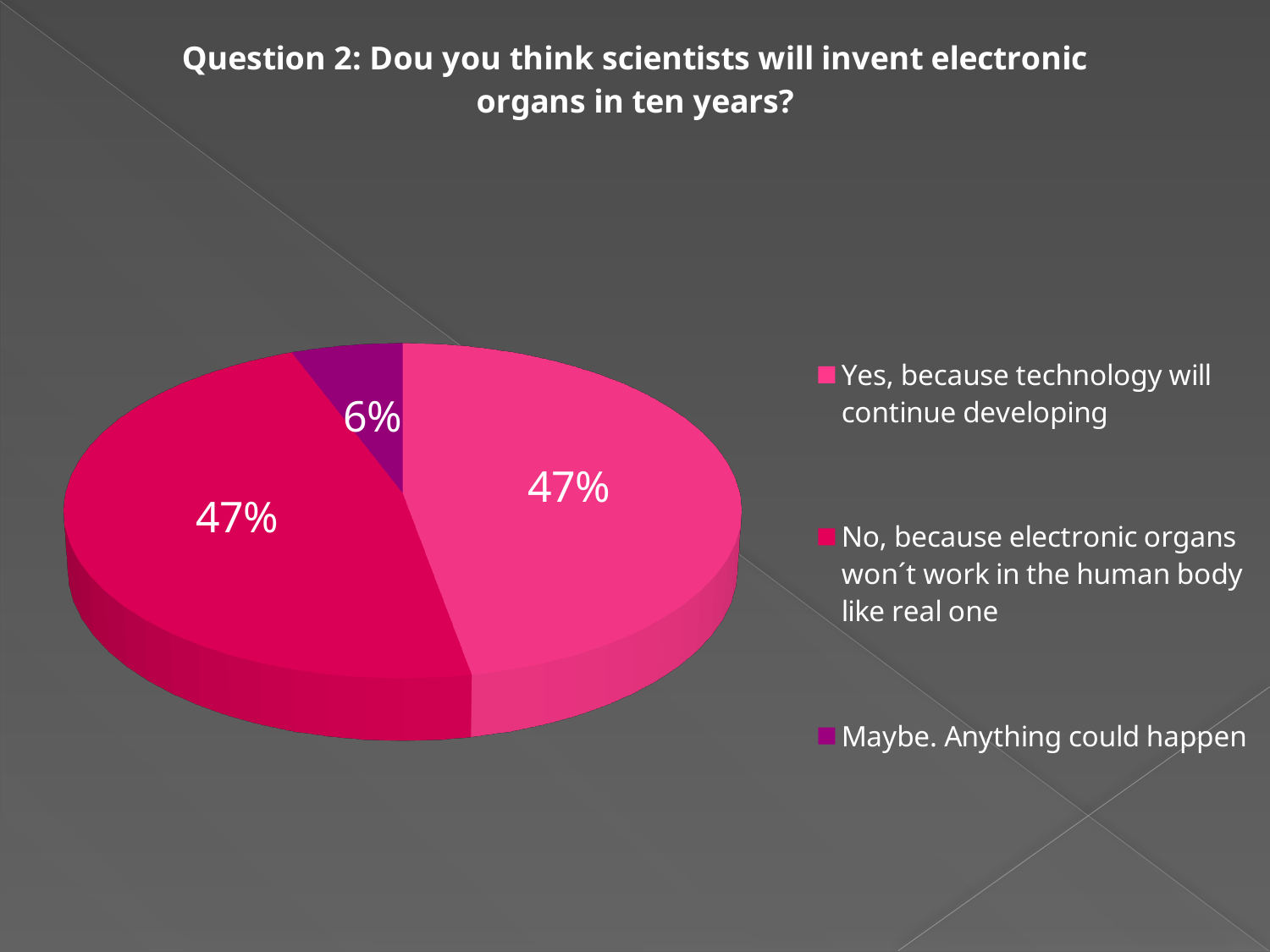
Which is larger: the share for "No, because electronic organs won't work in the human body like real one" or the share for "Maybe. Anything could happen"? No, because electronic organs won't work in the human body like real one How many slices does the pie chart have? 3 How many entries does the legend list? 3 What share of the pie is labelled "Maybe. Anything could happen"? 6% What kind of chart is shown on the slide? pie chart Which category has the smallest slice of the pie? Maybe. Anything could happen What share of the pie is labelled "Yes, because technology will continue developing"? 47% What is the difference between the share for "Yes, because technology will continue developing" and the share for "Maybe. Anything could happen"? 41% What share of the pie is labelled "No, because electronic organs won't work in the human body like real one"? 47% Which legend entry is shown in purple? Maybe. Anything could happen What is the title of the chart? Question 2: Dou you think scientists will invent electronic organs in ten years? Is the share for "Maybe. Anything could happen" greater or less than 10%? less